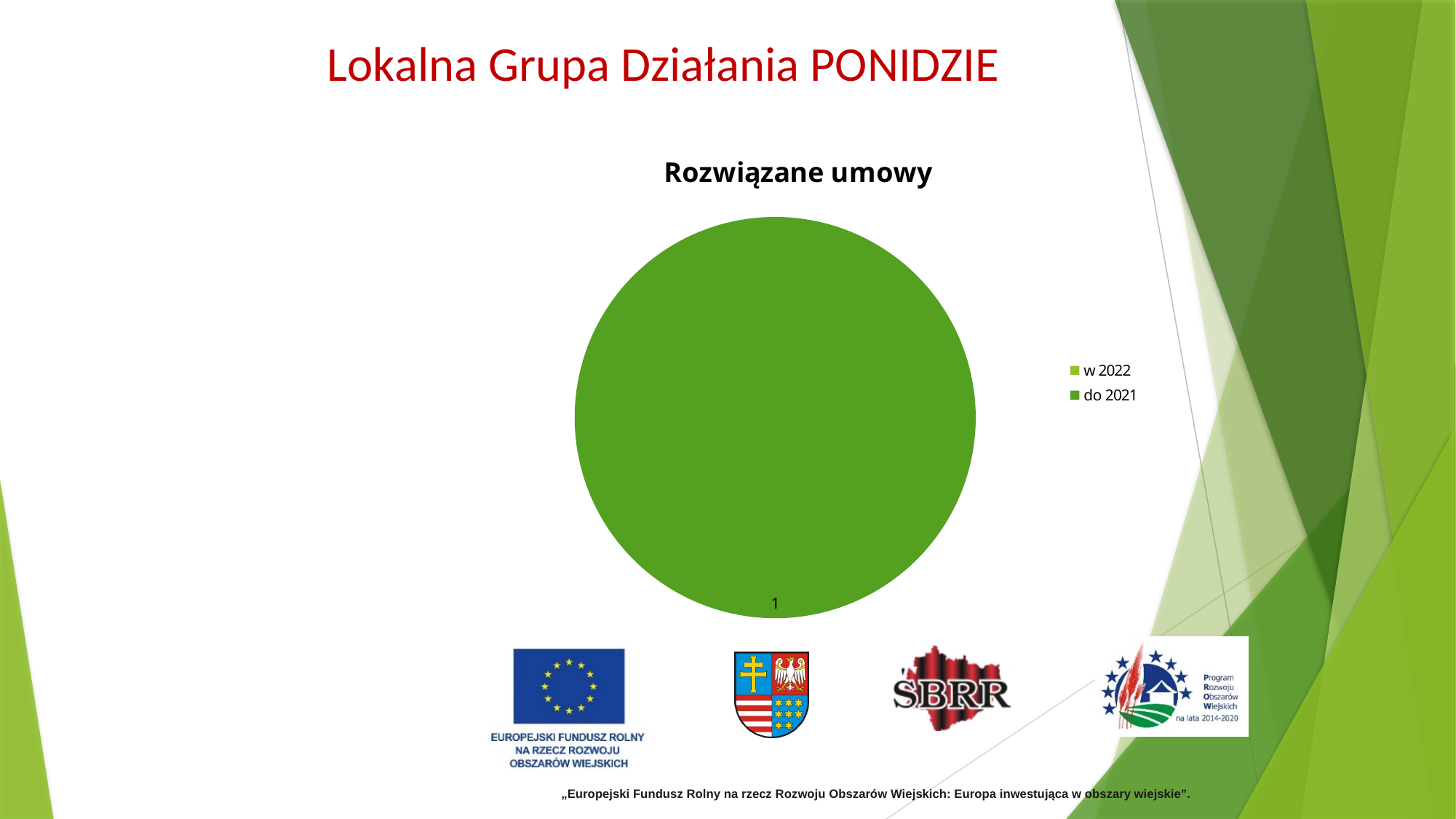
What value is printed as the data label on the pie? 1 What is the title of the chart? Rozwiązane umowy What kind of chart is shown on the slide? pie chart How many entries does the chart's legend list? 2 Which legend category has no visible slice in the pie? w 2022 What share of the pie does the 'do 2021' slice take up? 100% What are the two legend entries of the chart? w 2022, do 2021 Which category has the larger slice, 'w 2022' or 'do 2021'? do 2021 Which legend category does the visible slice of the pie belong to? do 2021